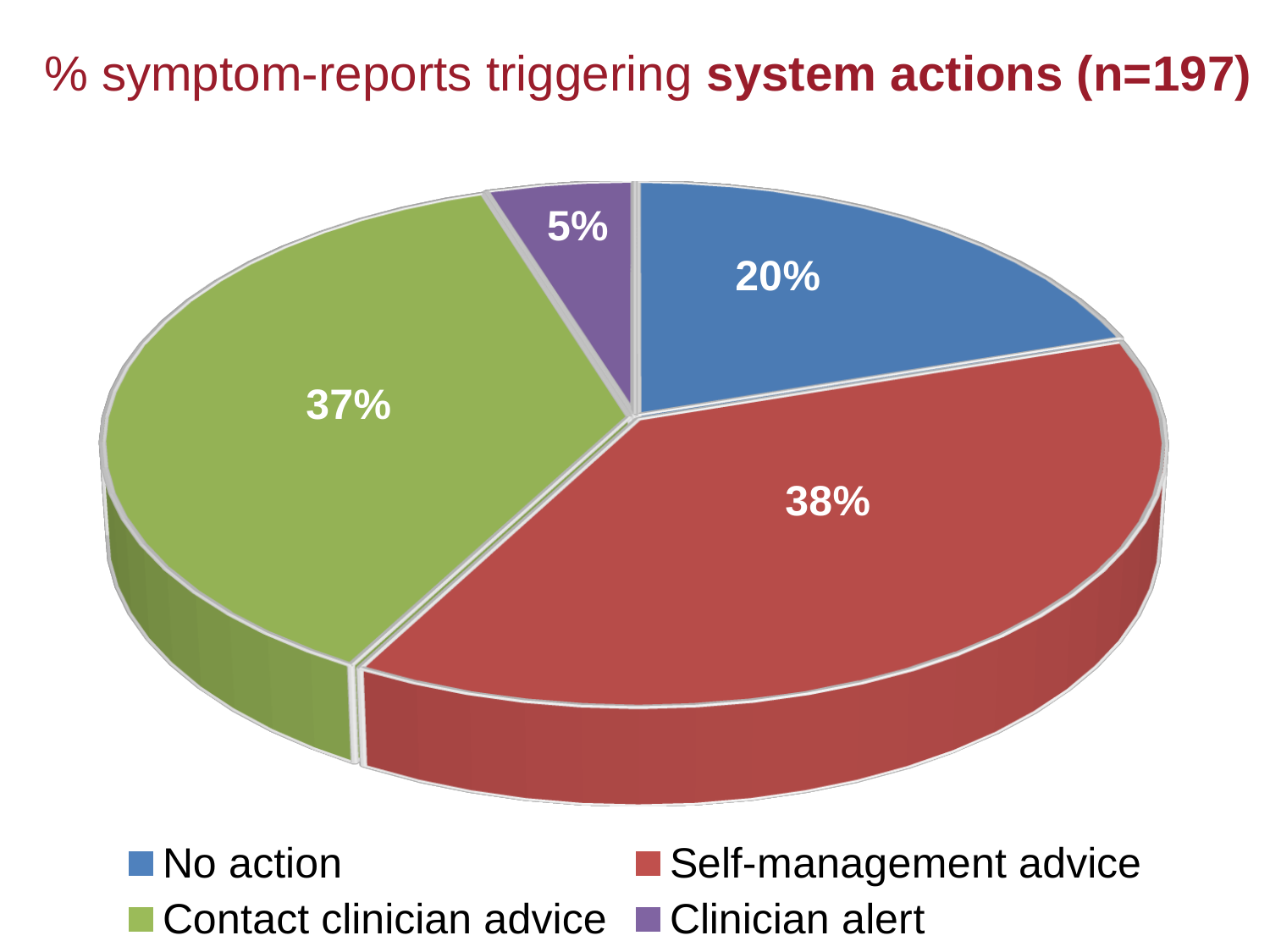
What percentage of symptom-reports triggered contact clinician advice? 37% What percentage of symptom-reports triggered self-management advice? 38% What percentage of symptom-reports triggered no action? 20% What kind of chart is shown on the slide? Pie chart What is the difference in percentage points between no action and clinician alert? 15 What percentage of symptom-reports triggered a clinician alert? 5% What is the combined share of self-management advice and contact clinician advice? 75% What is the difference in percentage points between self-management advice and no action? 18 Which is larger: the share for no action or the share for clinician alert? No action What colour represents contact clinician advice in the pie chart? Green Which system action has the smallest share of symptom-reports? Clinician alert How many categories does the pie chart show? 4